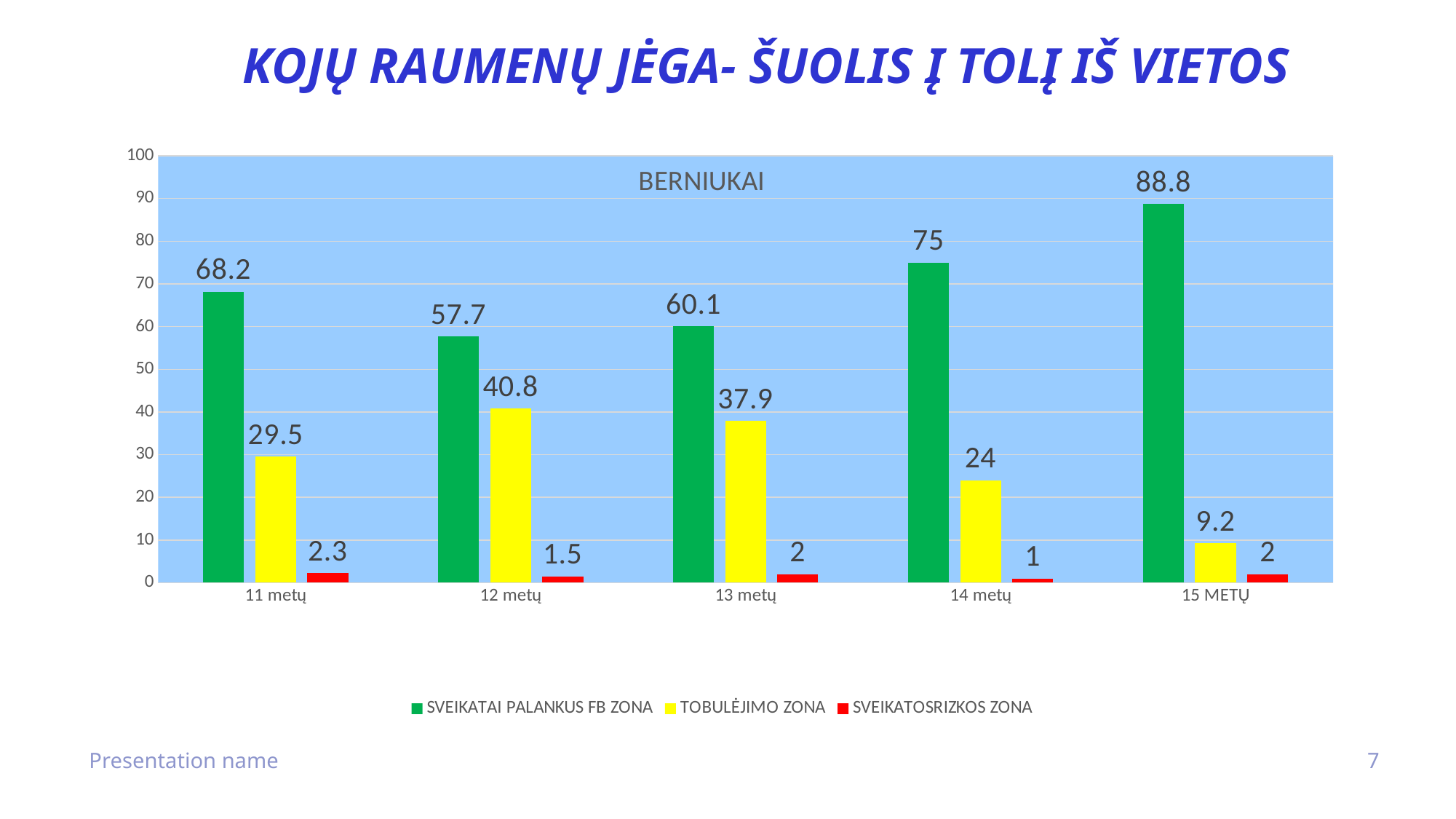
What kind of chart is shown on the slide? Bar chart Which is larger: the TOBULĖJIMO ZONA value for 12 metų or for 13 metų? 12 metų Which age group has the lowest value for TOBULĖJIMO ZONA? 15 METŲ Which colour represents SVEIKATOSRIZKOS ZONA in the legend? Red What is the value of SVEIKATOSRIZKOS ZONA for 14 metų? 1 Which age group has the highest value for SVEIKATAI PALANKUS FB ZONA? 15 METŲ What is the value of SVEIKATAI PALANKUS FB ZONA for 11 metų? 68.2 How many age groups are shown on the x axis? 5 What is the value of TOBULĖJIMO ZONA for 12 metų? 40.8 How many series does the legend list? 3 What is the difference between the SVEIKATAI PALANKUS FB ZONA values for 15 METŲ and 14 metų? 13.8 What is the title shown inside the chart area? BERNIUKAI